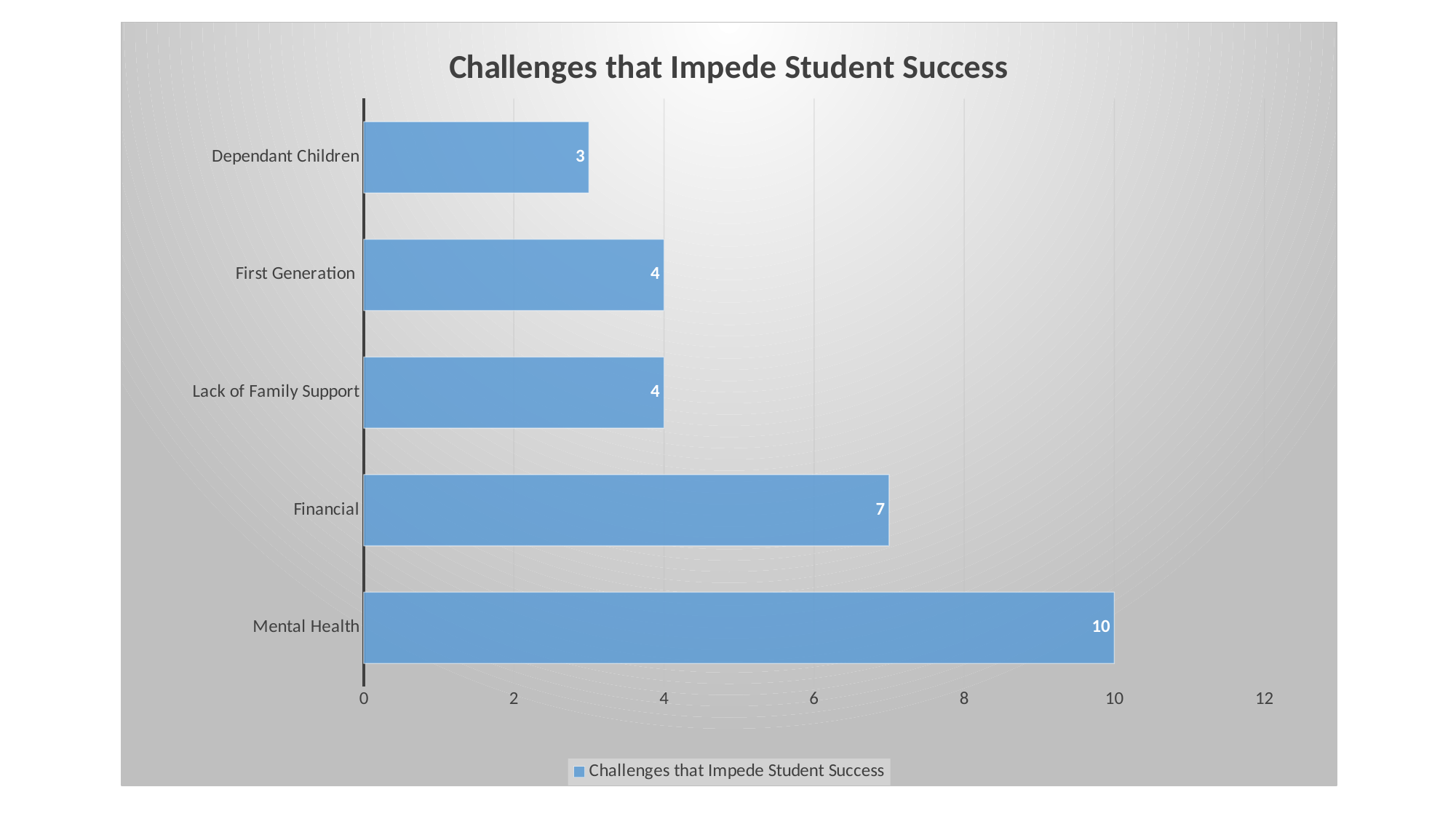
What is the value for First Generation? 4 What is the value for Financial? 7 Which is larger, the value for Financial or the value for Lack of Family Support? Financial Is the value for Financial greater or less than 6? greater How many categories are shown in the chart? 5 What kind of chart is shown on the slide? Bar chart What is the title of the chart? Challenges that Impede Student Success Which category has the highest value? Mental Health What is the value for Mental Health? 10 Which category has the lowest value? Dependant Children What is the difference between the values for Mental Health and Financial? 3 What is the value for Dependant Children? 3